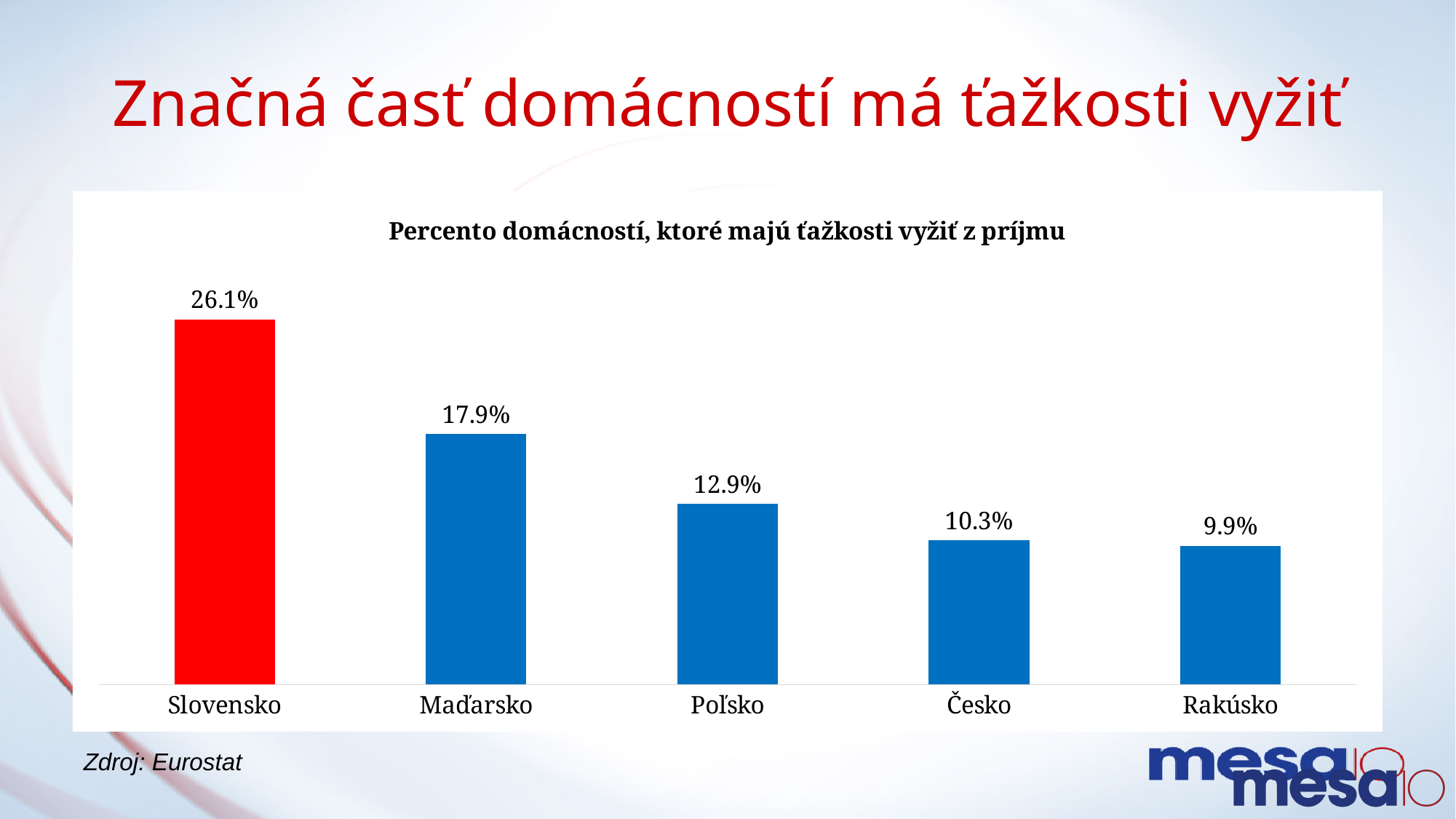
Which is larger, the value for Poľsko or the value for Česko? Poľsko Which bar is coloured red? Slovensko Which country has the highest value? Slovensko How many countries are shown in the chart? 5 What is the value for Maďarsko? 17.9% What is the value for Slovensko? 26.1% What kind of chart is shown on the slide? Bar chart What is the difference between the values for Česko and Rakúsko? 0.4% What is the difference between the values for Slovensko and Maďarsko? 8.2% What is the value for Poľsko? 12.9% What is the value for Rakúsko? 9.9% Which country has the lowest value? Rakúsko